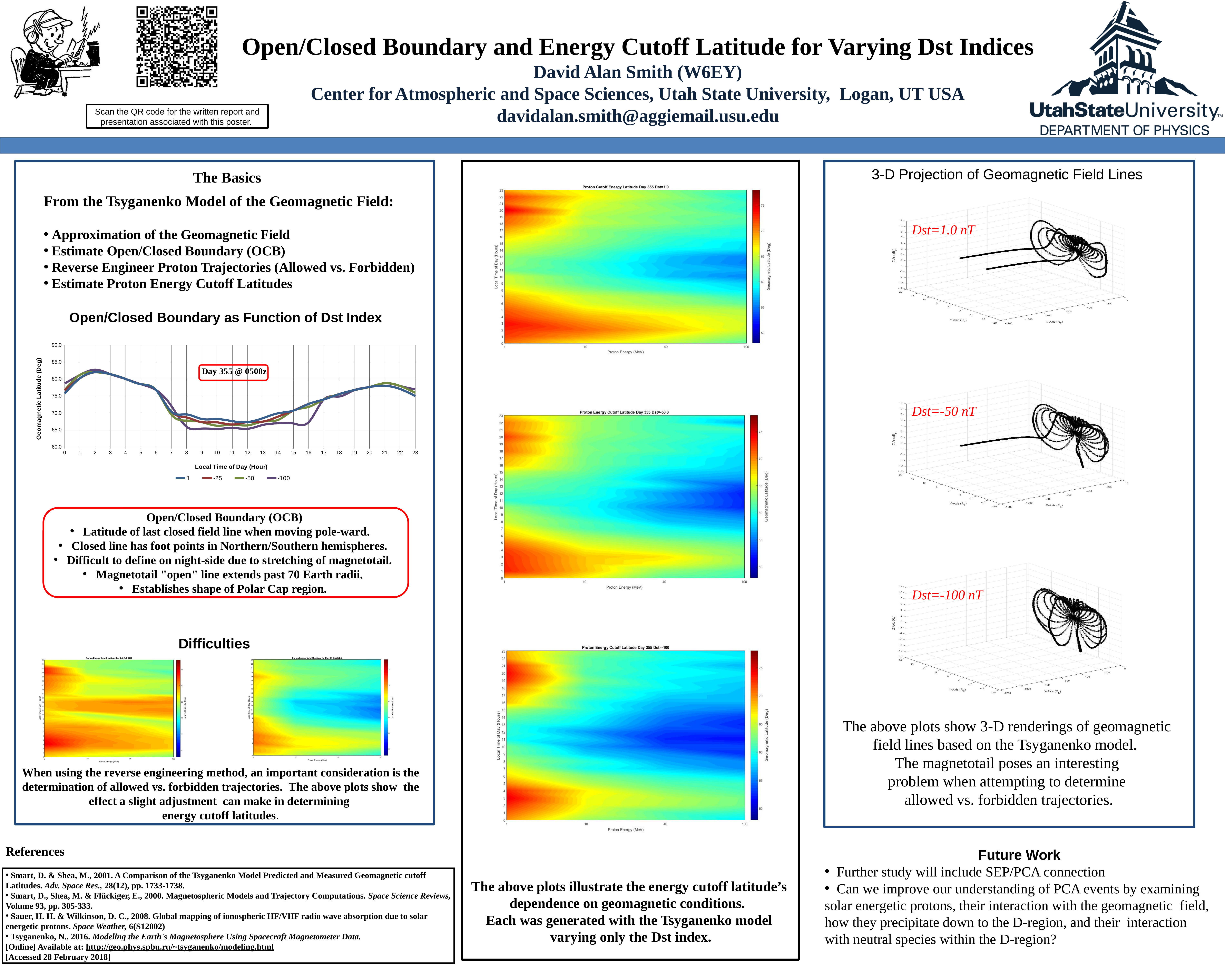
What kind of chart is "Open/Closed Boundary as Function of Dst Index"? line chart How many proton energy cutoff latitude heat-map plots are shown in the middle column of the slide? 3 How many hour ticks are shown on the x axis of the "Open/Closed Boundary as Function of Dst Index" chart? 24 In the "Open/Closed Boundary as Function of Dst Index" chart, do the values rise or fall between hour 2 and hour 12? fall In the "Open/Closed Boundary as Function of Dst Index" chart, is the value of series -100 at hour 12 greater or less than 70.0? less What is the x-axis title of the "Open/Closed Boundary as Function of Dst Index" chart? Local Time of Day (Hour) What are the legend entries of the "Open/Closed Boundary as Function of Dst Index" chart? 1, -25, -50, -100 In the "Open/Closed Boundary as Function of Dst Index" chart, is the value of series -50 at hour 21 greater or less than 75.0? greater How many series does the legend of the "Open/Closed Boundary as Function of Dst Index" chart list? 4 In the "Open/Closed Boundary as Function of Dst Index" chart, which is larger for series -100: the value at hour 2 or the value at hour 9? hour 2 In the "Open/Closed Boundary as Function of Dst Index" chart, at which hour do the series reach their highest geomagnetic latitude? 2 In the "Open/Closed Boundary as Function of Dst Index" chart, is the value of series 1 at hour 2 greater or less than 80.0? greater